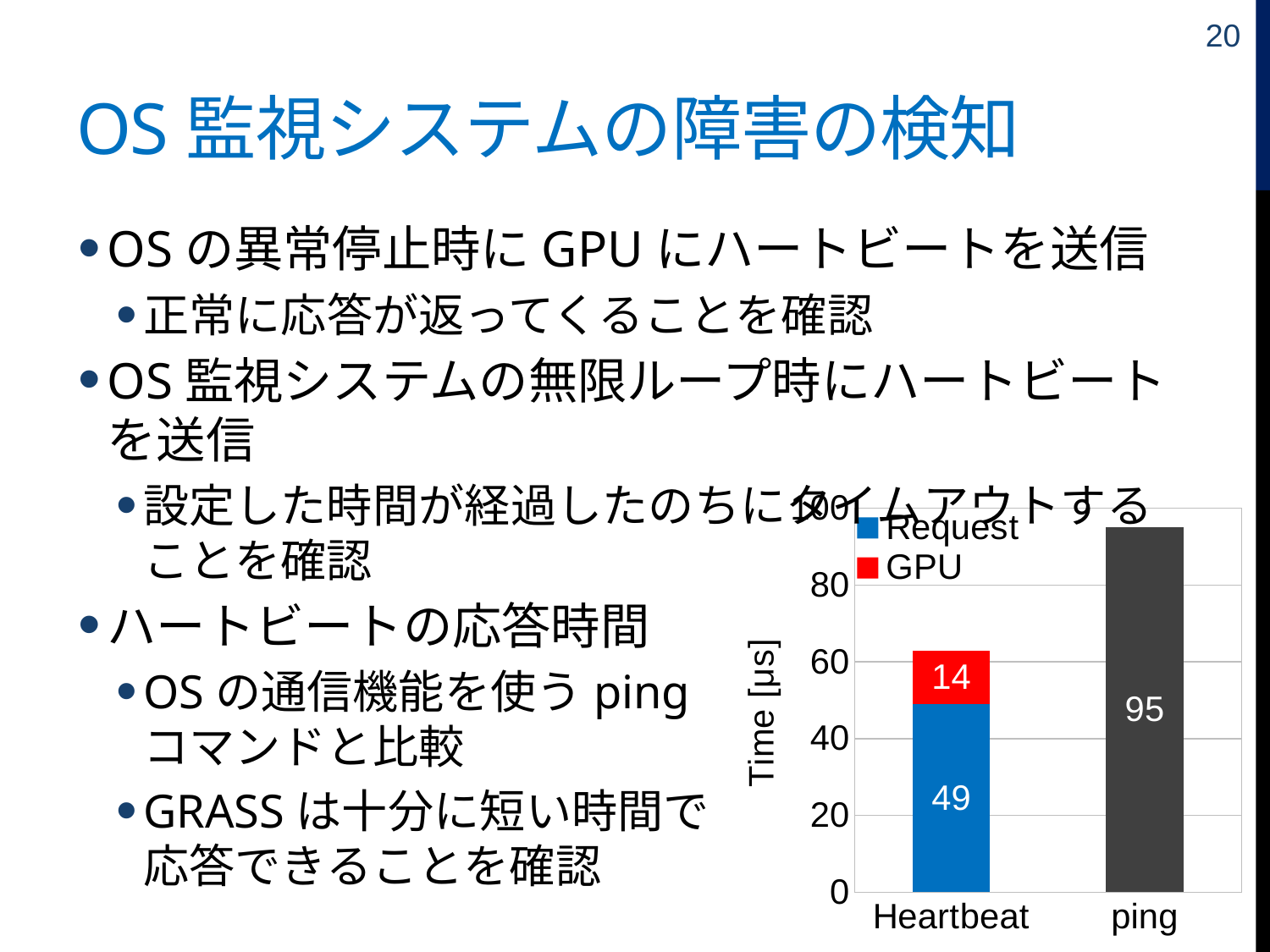
What is the total of the stacked Heartbeat bar? 63 What is the GPU value for Heartbeat? 14 How many series does the legend list? 2 What is the value for ping? 95 Is the value for ping greater or less than 80? greater Is the total for Heartbeat greater or less than 80? less What is the Request value for Heartbeat? 49 How many categories are shown on the x axis? 2 What is the difference between the ping value and the Request value for Heartbeat? 46 What kind of chart is shown? stacked bar chart Which category has the taller bar, Heartbeat or ping? ping What is the label of the y axis? Time [µs]